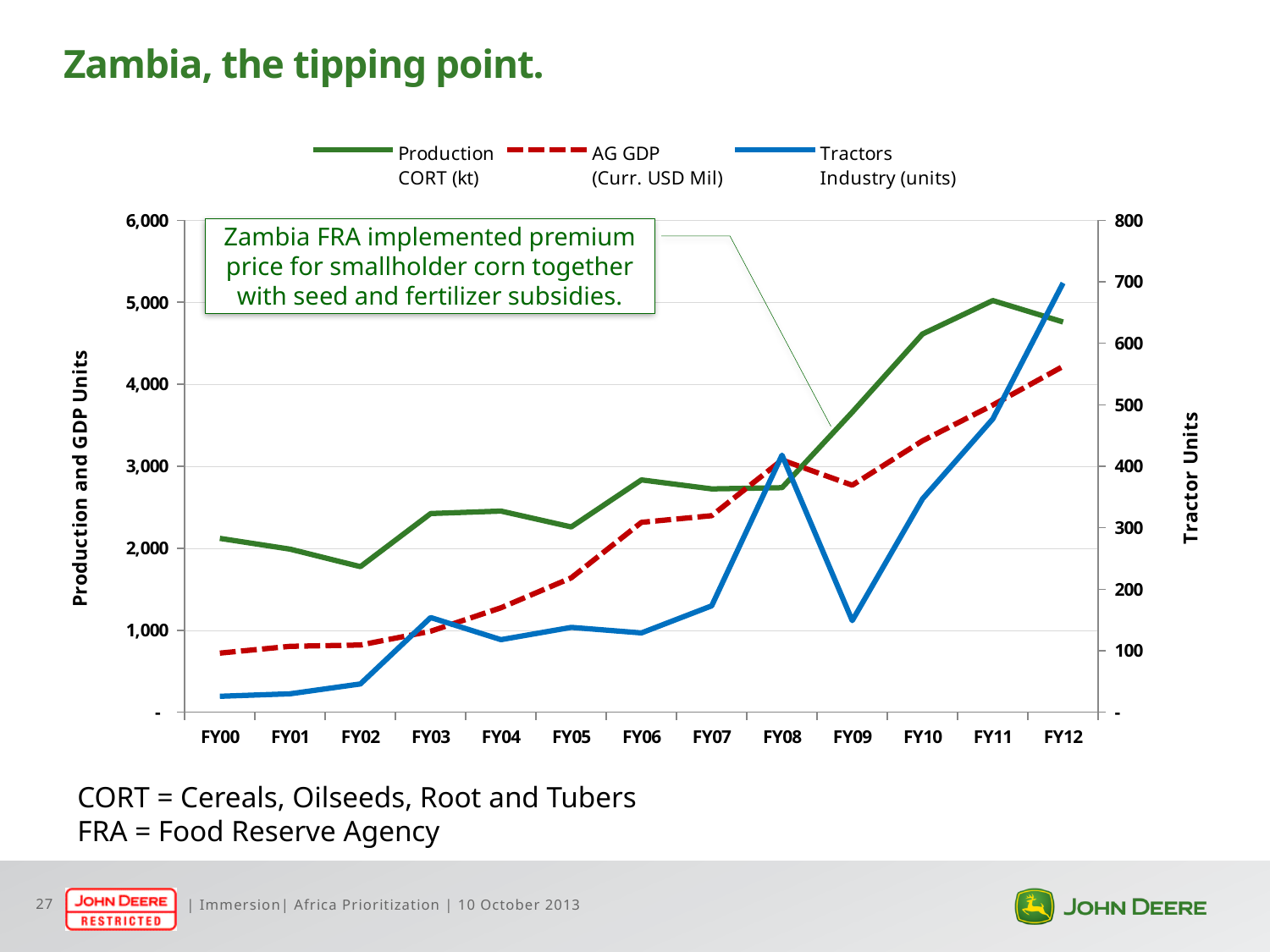
Does AG GDP (Curr. USD Mil) generally rise or fall from FY00 to FY12? rise Is the value for Production CORT (kt) in FY12 greater or less than 4,000? greater Is the value for AG GDP (Curr. USD Mil) in FY00 greater or less than 1,000? less What kind of chart is shown on the slide? Line chart In which fiscal year does Tractors Industry (units) reach its highest value? FY12 Is the value for Tractors Industry (units) in FY08 greater or less than 300? greater How many fiscal years are plotted along the x axis? 13 In which fiscal year does Production CORT (kt) reach its highest value? FY11 Which series is drawn as a red dashed line? AG GDP (Curr. USD Mil) Which is larger, Production CORT (kt) in FY10 or in FY05? FY10 In which fiscal year is Production CORT (kt) at its lowest? FY02 How many series does the legend list? 3